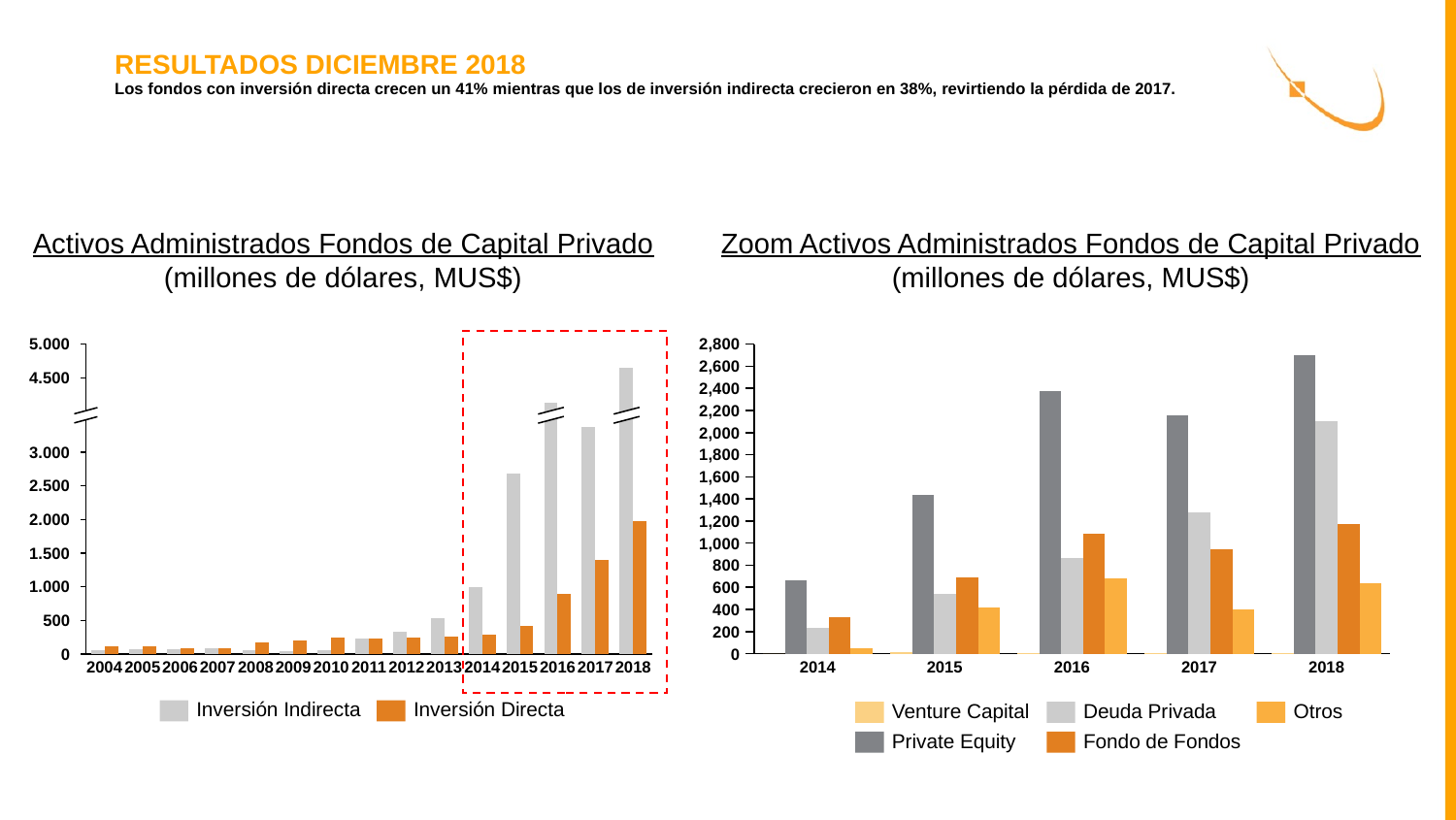
In the left chart, 'Activos Administrados Fondos de Capital Privado', which is larger in 2018: Inversión Indirecta or Inversión Directa? Inversión Indirecta In the right chart, 'Zoom Activos Administrados Fondos de Capital Privado', is the Private Equity value for 2016 greater or less than 2,200? greater In the left chart, 'Activos Administrados Fondos de Capital Privado', which year has the highest Inversión Indirecta value? 2018 In the right chart, 'Zoom Activos Administrados Fondos de Capital Privado', does the Deuda Privada value rise or fall from 2014 to 2018? Rises In the right chart, 'Zoom Activos Administrados Fondos de Capital Privado', which is larger in 2015: Fondo de Fondos or Otros? Fondo de Fondos What kind of chart is the left chart, 'Activos Administrados Fondos de Capital Privado'? Bar chart In the left chart, 'Activos Administrados Fondos de Capital Privado', is the Inversión Indirecta value for 2015 greater or less than 2.500? greater In the left chart, 'Activos Administrados Fondos de Capital Privado', is the Inversión Directa value for 2018 greater or less than 1.500? greater In the right chart, 'Zoom Activos Administrados Fondos de Capital Privado', how many series does the legend list? 5 In the left chart, 'Activos Administrados Fondos de Capital Privado', how many series does the legend list? 2 In the left chart, 'Activos Administrados Fondos de Capital Privado', how many years are shown on the x axis? 15 In the right chart, 'Zoom Activos Administrados Fondos de Capital Privado', how many years are shown on the x axis? 5